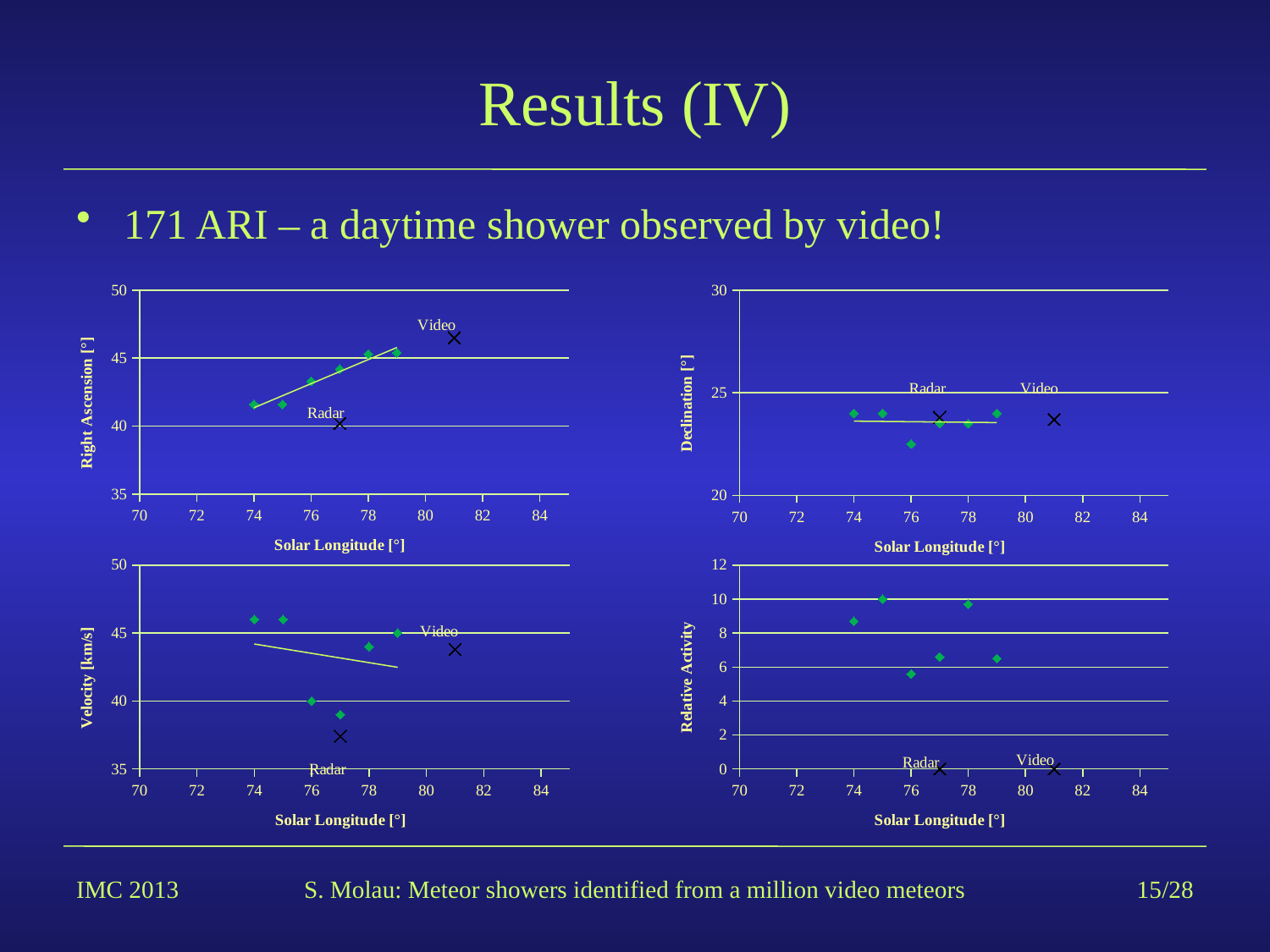
How many charts are shown on the slide? 4 In the Relative Activity chart (bottom right), at which solar longitude is the green data point lowest? 76 In the Declination chart (top right), is the Video marker greater or less than 25? less In the Right Ascension chart (top left), what kind of chart is it? scatter chart In the Right Ascension chart (top left), how many green data points are plotted? 6 In the Velocity chart (bottom left), at which solar longitude is the green data point lowest? 77 In the Velocity chart (bottom left), is the green data point at solar longitude 74 greater or less than 45? greater In the Velocity chart (bottom left), which is larger: the green data point at solar longitude 75 or at 76? 75 In the Right Ascension chart (top left), do the green data points rise or fall as solar longitude increases? rise In the Declination chart (top right), at which solar longitude is the green data point lowest? 76 In the Relative Activity chart (bottom right), is the green data point at solar longitude 74 greater or less than 8? greater